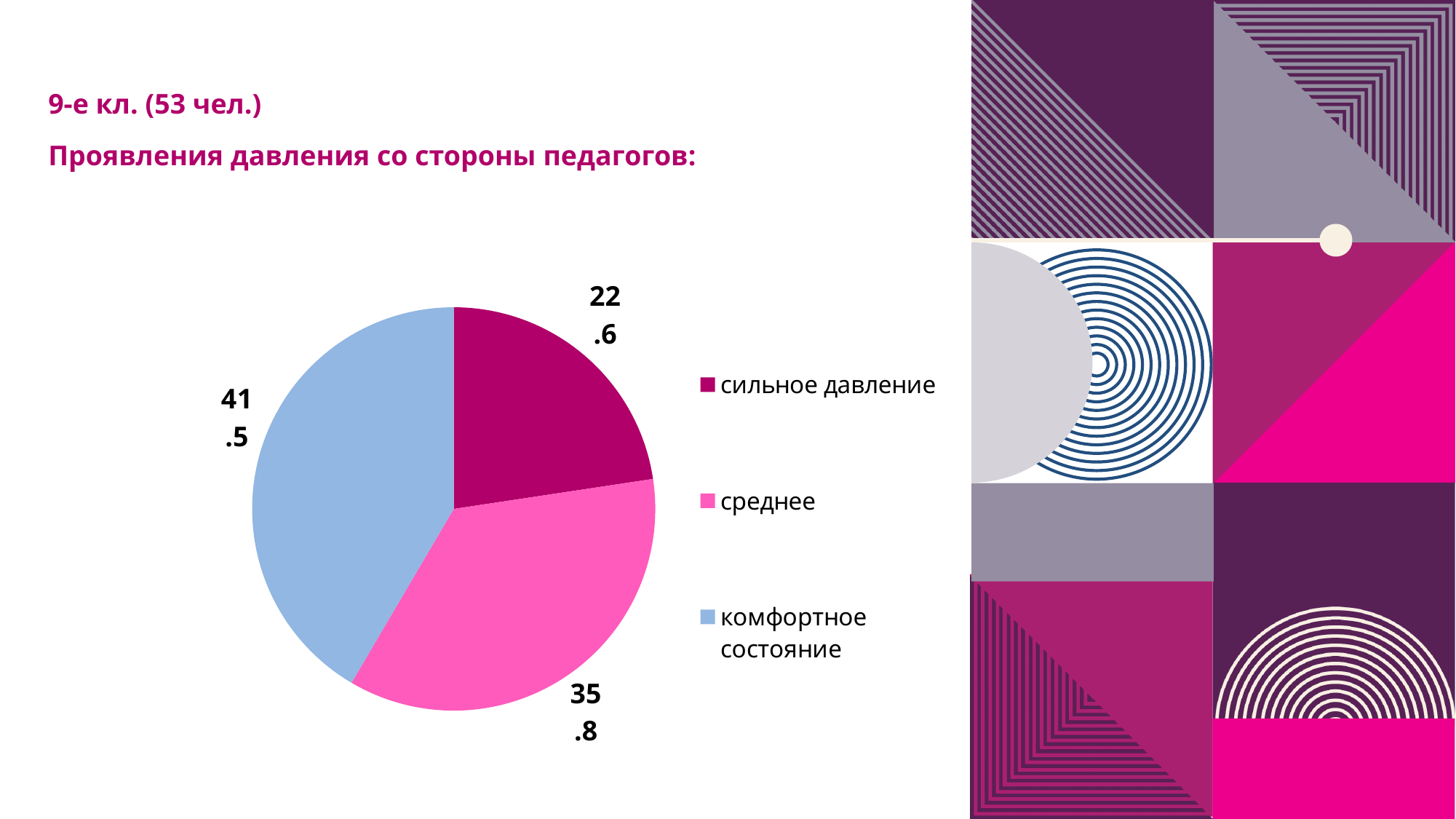
Which category has the largest slice in the pie chart? комфортное состояние What kind of chart is shown on the slide? pie chart What is the difference between the values for "среднее" and "сильное давление"? 13.2 What is the value for "среднее" in the pie chart? 35.8 What is the difference between the values for "комфортное состояние" and "сильное давление"? 18.9 How many entries does the legend list? 3 What is the value for "сильное давление" in the pie chart? 22.6 Which category has the smallest slice in the pie chart? сильное давление Which is larger, the value for "среднее" or the value for "сильное давление"? среднее How many slices does the pie chart have? 3 What is the value for "комфортное состояние" in the pie chart? 41.5 What colour is the slice for "комфортное состояние"? light blue